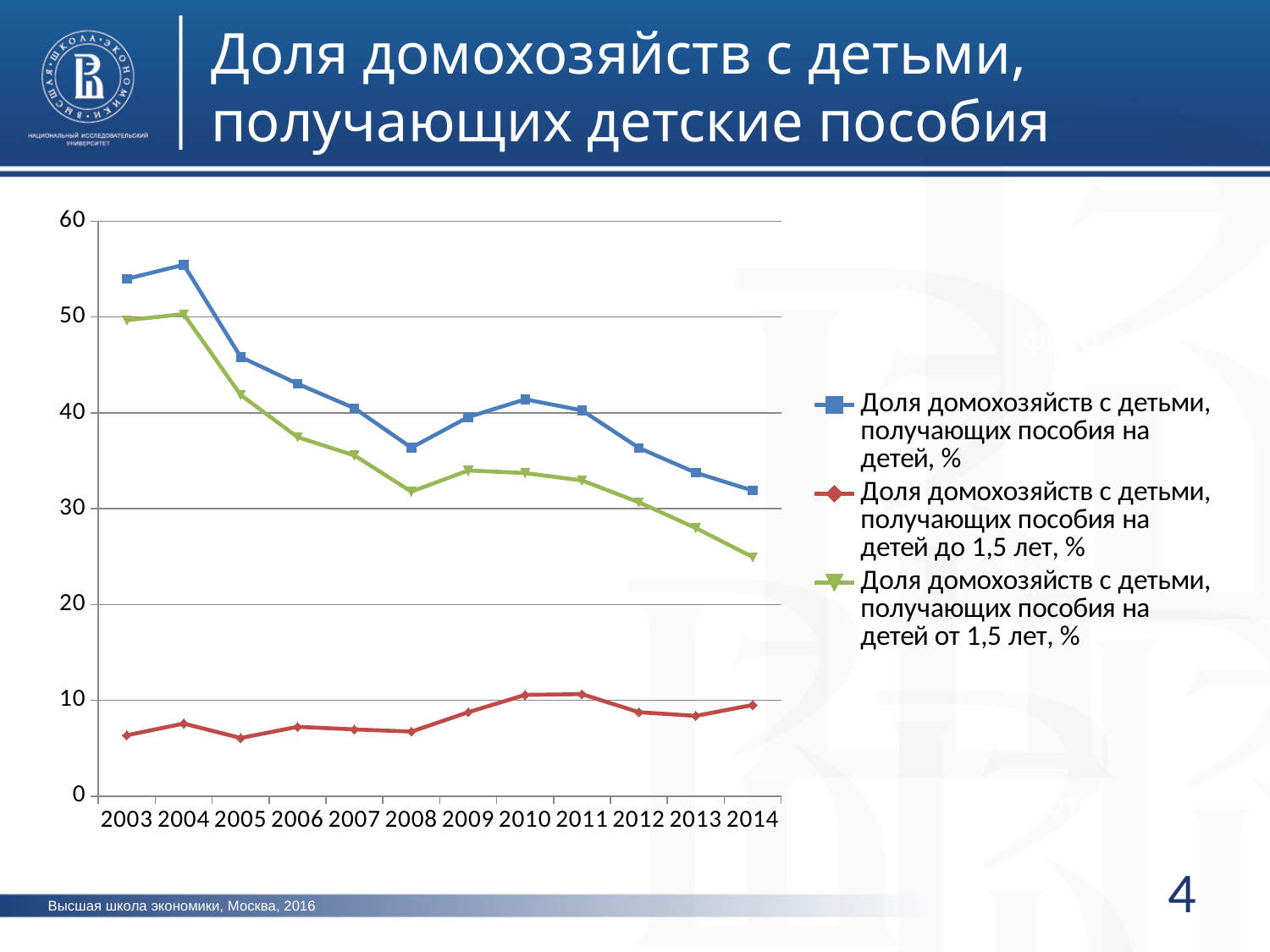
In which year is the series "Доля домохозяйств с детьми, получающих пособия на детей, %" at its lowest? 2014 Does the series "Доля домохозяйств с детьми, получающих пособия на детей, %" overall rise or fall from 2003 to 2014? Fall For "Доля домохозяйств с детьми, получающих пособия на детей, %", which year has the larger value: 2008 or 2010? 2010 Is the 2014 value for "Доля домохозяйств с детьми, получающих пособия на детей от 1,5 лет, %" greater or less than 30? less Is the 2003 value for "Доля домохозяйств с детьми, получающих пособия на детей до 1,5 лет, %" greater or less than 10? less How many series does the legend list? 3 In which year is the series "Доля домохозяйств с детьми, получающих пособия на детей, %" at its highest? 2004 How many years are plotted along the x axis? 12 Is the 2003 value for "Доля домохозяйств с детьми, получающих пособия на детей, %" greater or less than 50? greater Which series is drawn with the green line with triangle markers? Доля домохозяйств с детьми, получающих пособия на детей от 1,5 лет, % In which year is the series "Доля домохозяйств с детьми, получающих пособия на детей от 1,5 лет, %" at its lowest? 2014 What kind of chart is shown on the slide? Line chart